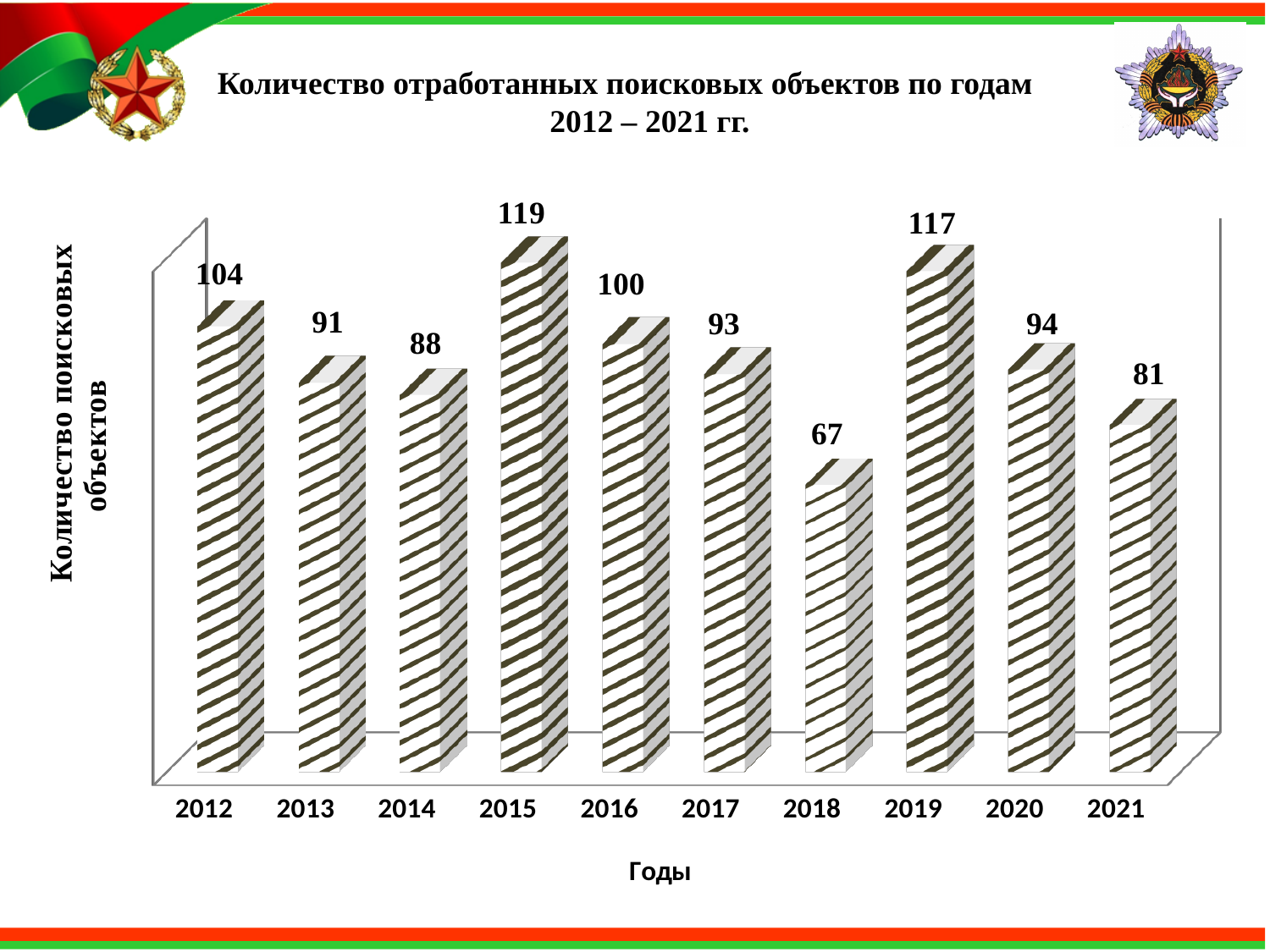
Which is larger, the value for 2012 or the value for 2016? 2012 What is the difference between the values for 2019 and 2020? 23 What is the value for 2021? 81 How many years are shown on the x axis? 10 Which year has the highest value? 2015 What is the value for 2015? 119 Which is larger, the value for 2013 or the value for 2014? 2013 What is the label of the x axis? Годы What kind of chart is shown on the slide? bar chart What is the value for 2018? 67 What is the difference between the values for 2015 and 2018? 52 Which year has the lowest value? 2018